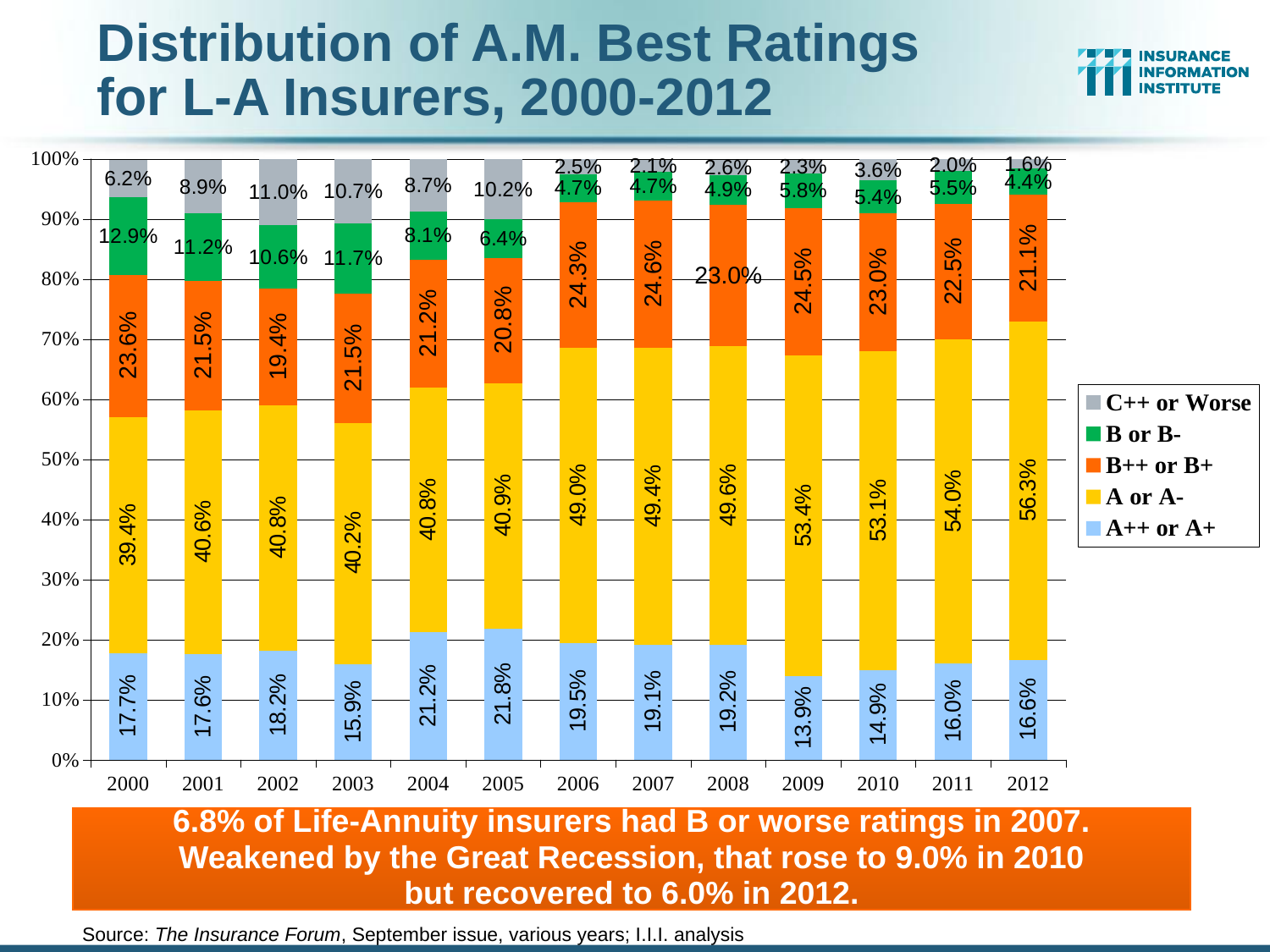
Does the A or A- share generally rise or fall from 2000 to 2012? Rise How many years are shown along the x axis? 13 In which year is the A++ or A+ share the lowest? 2009 How many series does the legend list? 5 What is the share of insurers rated A++ or A+ in 2005? 21.8% What kind of chart is shown on the slide? Stacked bar chart Which is larger, the B++ or B+ share in 2007 or in 2012? 2007 What is the combined share of B or B- and C++ or Worse ratings in 2007? 6.8% What is the share of insurers rated C++ or Worse in 2002? 11.0% In which year is the A or A- share the highest? 2012 What is the difference between the A or A- share in 2012 and in 2000? 16.9% What is the share of L-A insurers rated A or A- in 2012? 56.3%